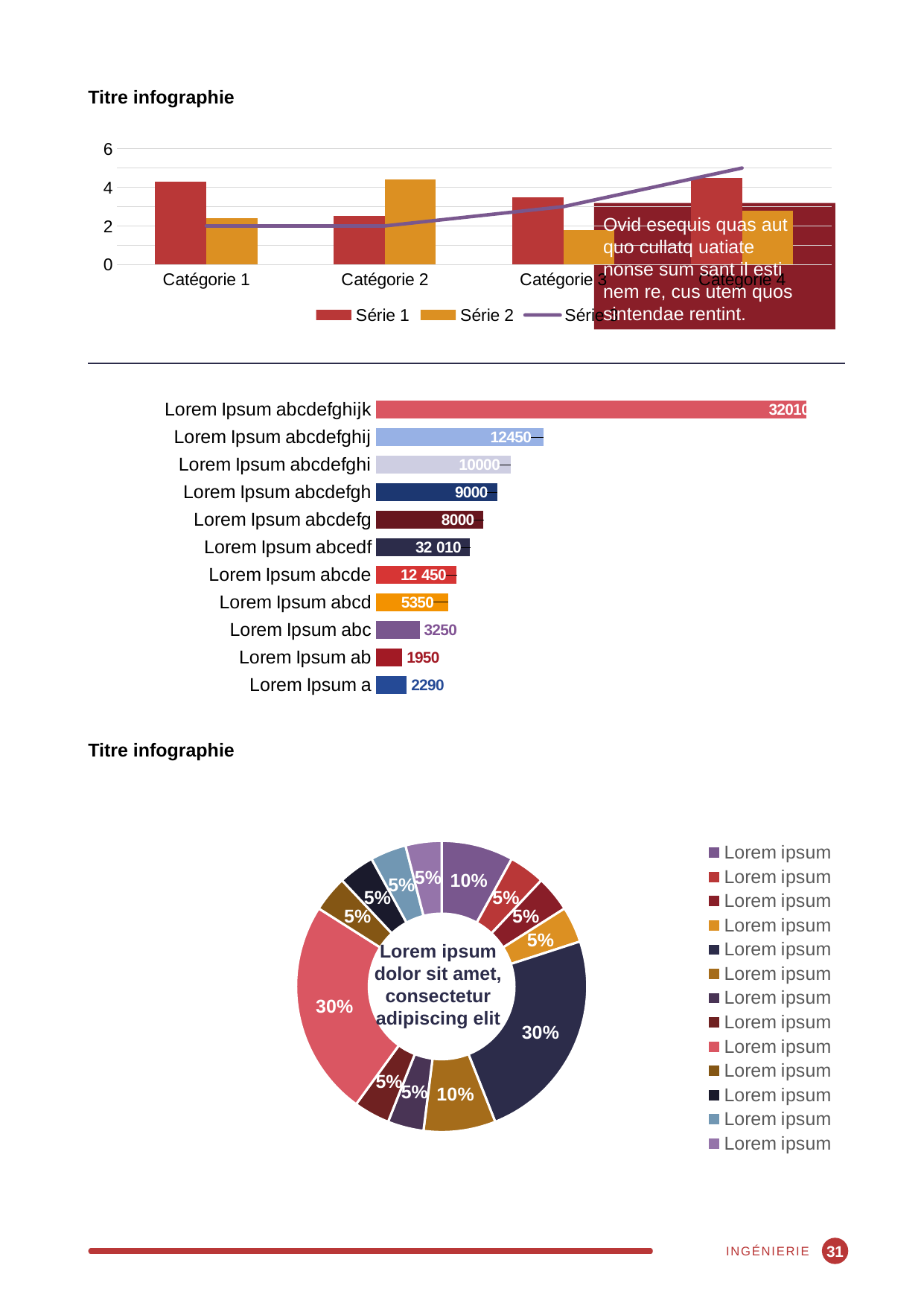
In the top chart, which series is drawn as a line rather than bars? Série 3 In the middle bar chart, which is larger, the value for Lorem Ipsum ab or the value for Lorem Ipsum a? Lorem Ipsum a In the middle bar chart, what is the difference between the values for Lorem Ipsum abcdefgh and Lorem Ipsum abcdefg? 1000 In the middle bar chart, what is the value for Lorem Ipsum abcdefghij? 12450 In the top chart, is the Série 2 value for Catégorie 2 greater or less than 4? greater What kind of chart is the middle chart on the slide? Bar chart What kind of chart is the chart at the top of the slide? A combined bar and line chart In the doughnut chart at the bottom, how many entries does the legend list? 13 In the top chart, how many categories are shown on the x axis? 4 In the middle bar chart, what is the value for Lorem Ipsum abcd? 5350 In the middle bar chart, how many categories are listed? 11